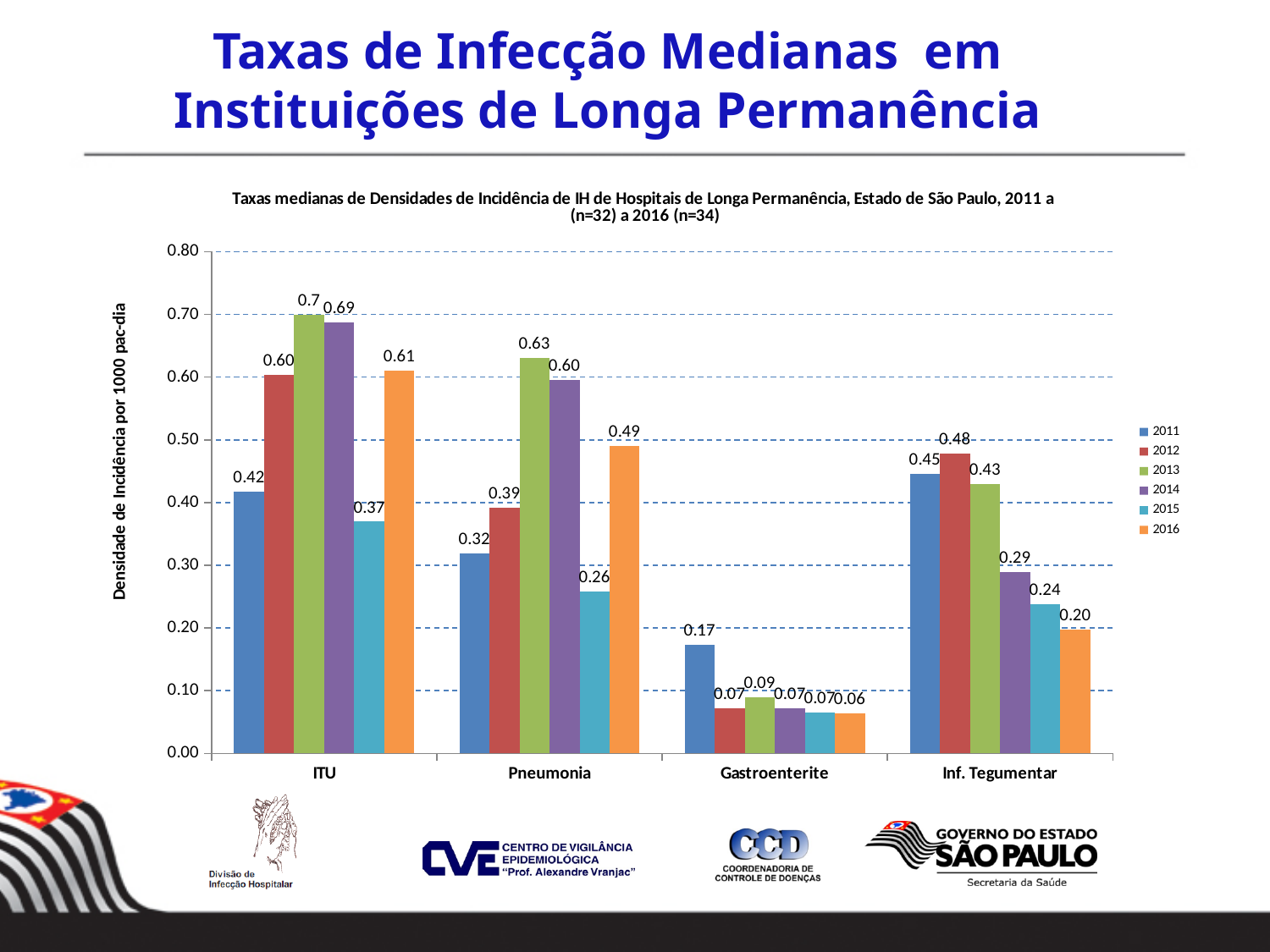
What is the value for Pneumonia in 2016? 0.49 What is the value for Gastroenterite in 2011? 0.17 What is the difference between the Pneumonia values for 2013 and 2015? 0.37 For Inf. Tegumentar, which year has the lowest value? 2016 For ITU, which year has the highest value? 2013 What kind of chart is shown on the slide? Bar chart What is the value for Inf. Tegumentar in 2015? 0.24 How many series does the legend list? 6 For Inf. Tegumentar, do the values rise or fall from 2012 to 2016? Fall What is the value for ITU in 2013? 0.7 Which is larger in 2012: the value for ITU or the value for Inf. Tegumentar? ITU How many infection categories are shown on the x axis? 4